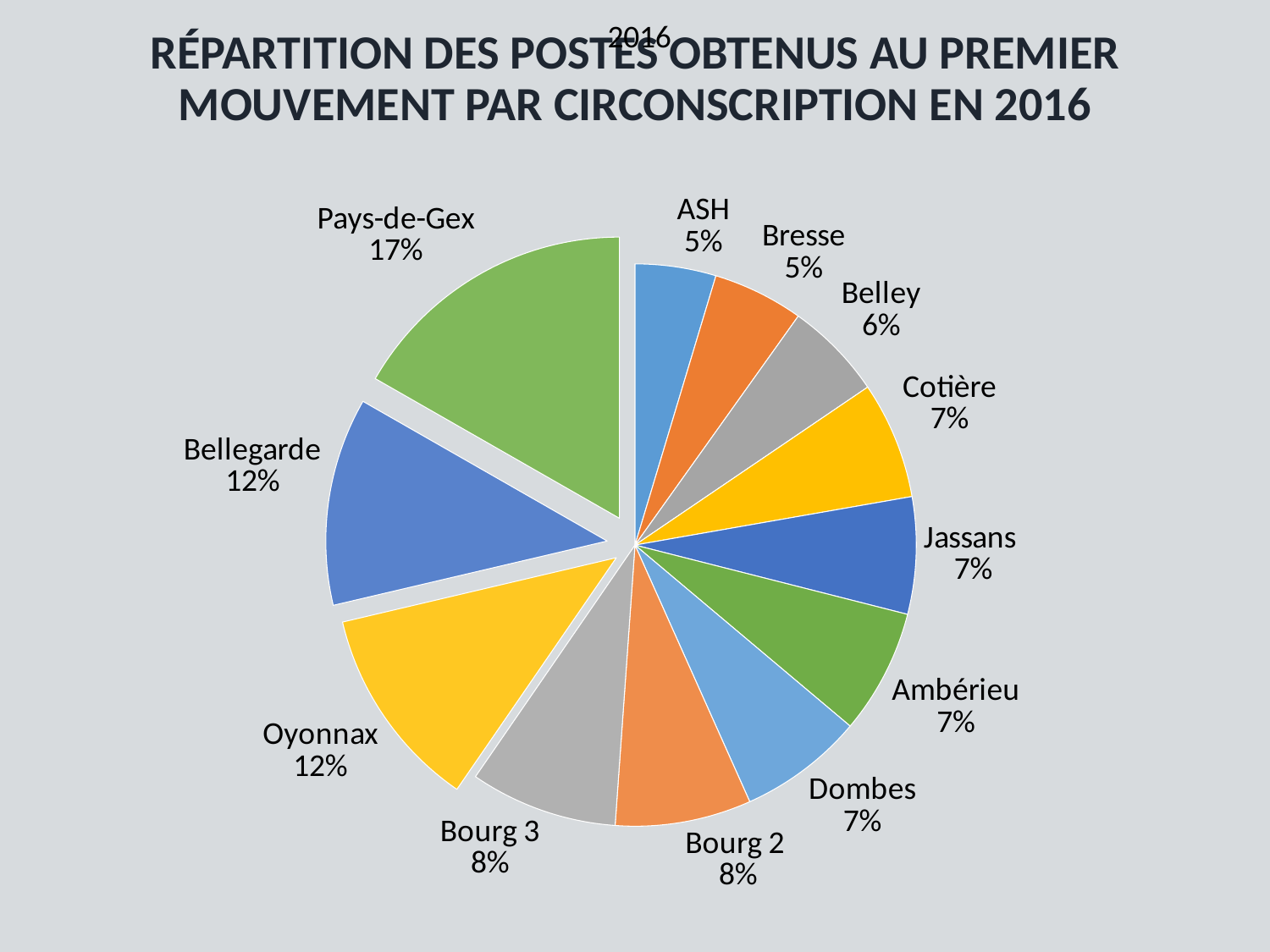
Which circonscription has the largest slice of the pie? Pays-de-Gex What percentage is shown for Bourg 2? 8% Which is larger, the slice for Belley or the slice for Bresse? Belley What share of the pie does Pays-de-Gex have? 17% How many circonscriptions (slices) are shown in the pie chart? 12 What is the difference in percentage points between Pays-de-Gex and Oyonnax? 5 Which is larger, the slice for Bellegarde or the slice for Cotière? Bellegarde What is the value for Belley? 6% Which three slices are pulled out (exploded) from the pie? Pays-de-Gex, Bellegarde, Oyonnax What type of chart is shown on the slide? Pie chart What percentage is shown for Bellegarde? 12% What is the difference in percentage points between Bourg 3 and ASH? 3